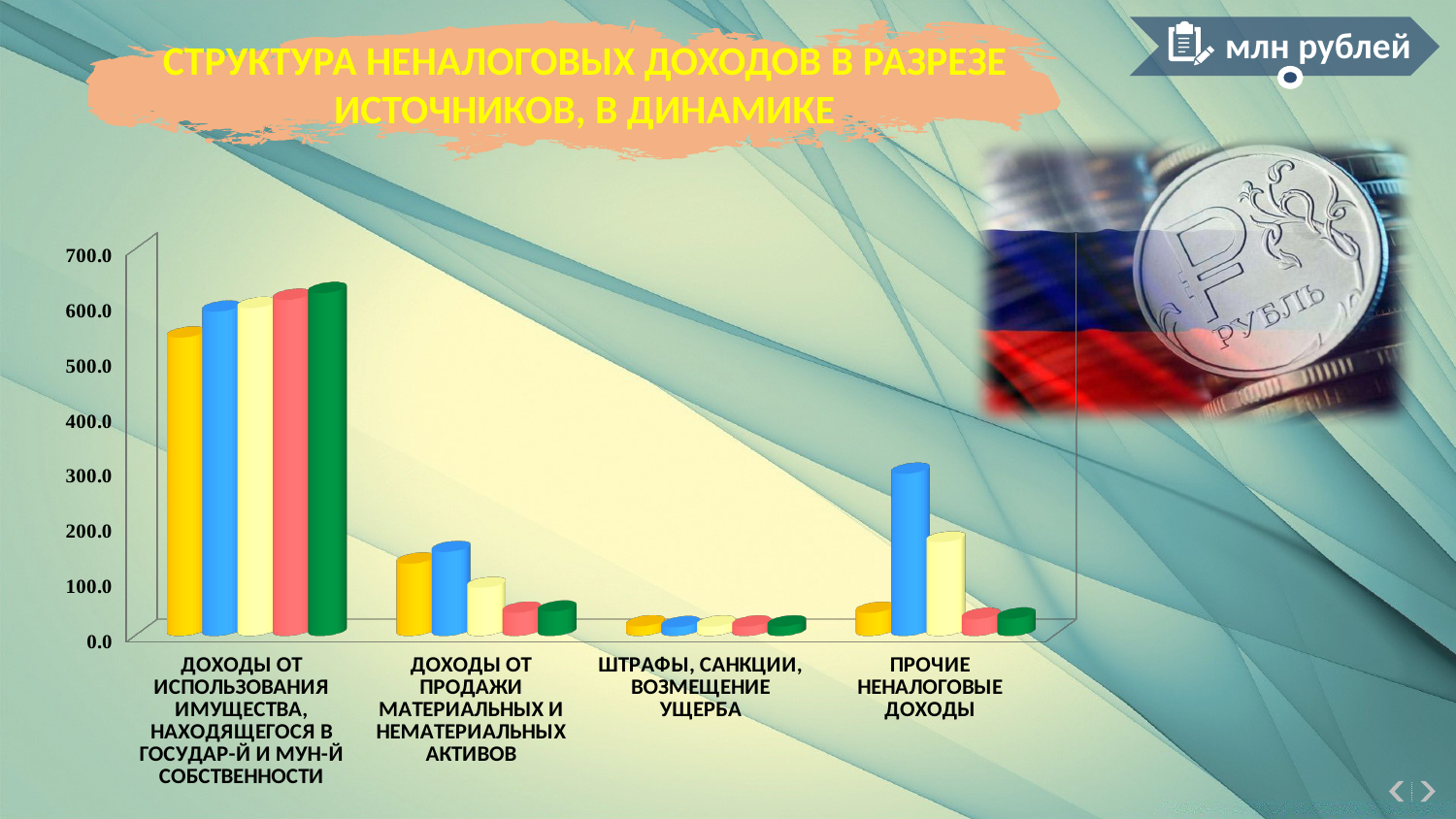
Is the value of the green bar for 'Доходы от продажи материальных и нематериальных активов' greater or less than 100? less Which category has the tallest bars in the chart? Доходы от использования имущества, находящегося в государ-й и мун-й собственности What kind of chart is shown on the slide? bar chart In what units are the values on the chart expressed, according to the label in the top right corner? млн рублей Which category has the lowest bars in the chart? Штрафы, санкции, возмещение ущерба Is the value of the first (yellow) bar for 'Доходы от использования имущества' greater or less than 500? greater Do the bars for 'Доходы от использования имущества' rise or fall from left to right within the group? rise For 'Прочие неналоговые доходы', which bar is larger: the blue bar or the pink bar? the blue bar How many bars are plotted for each category in the chart? 5 How many categories are shown on the x axis of the chart? 4 Is the value of the blue bar for 'Прочие неналоговые доходы' greater or less than 200? greater